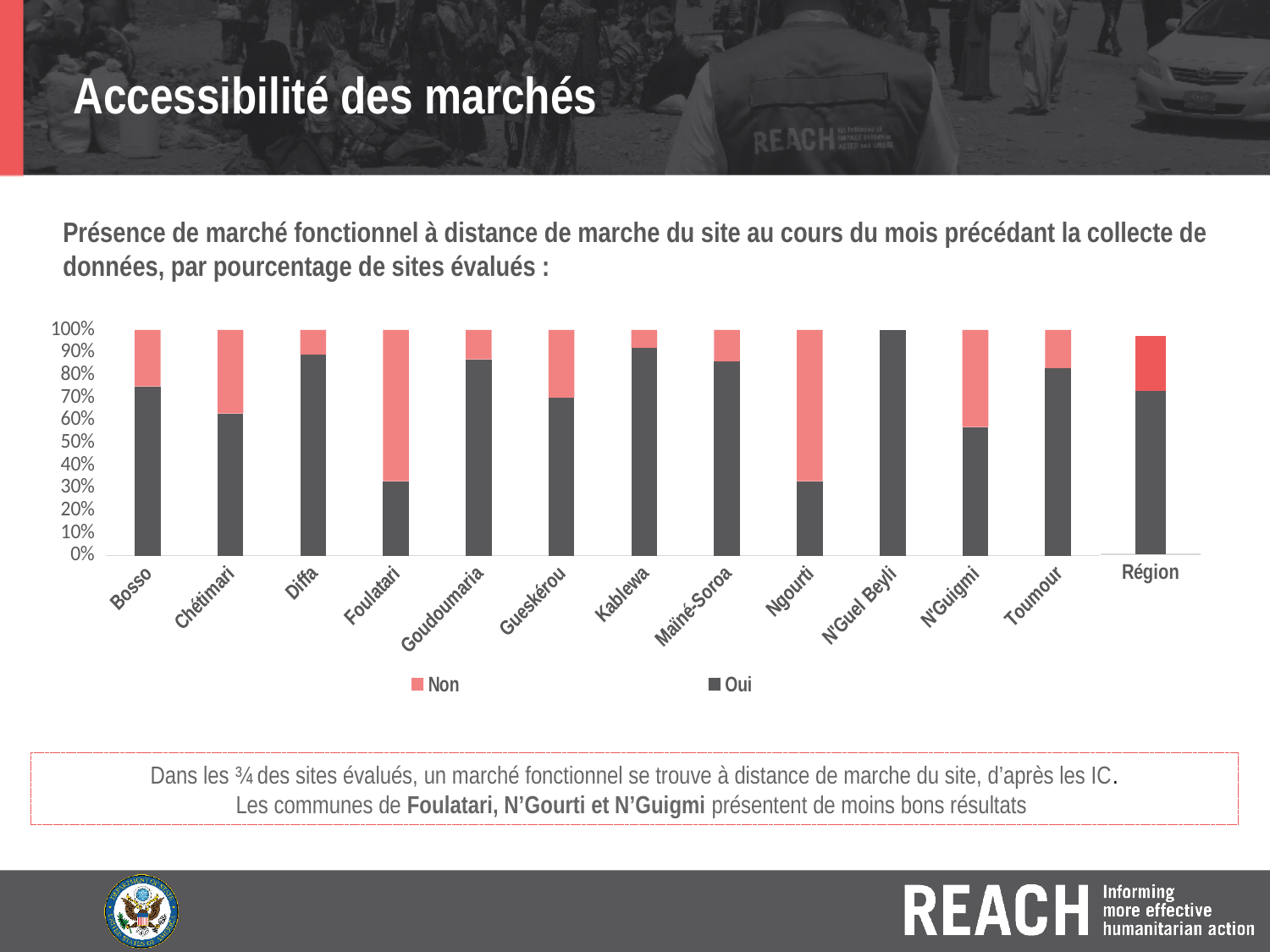
How many series does the chart legend list? 2 Is the 'Oui' value for Région greater or less than 60%? greater Is the 'Oui' value for Kablewa greater or less than 80%? greater Which category has the highest share of 'Oui'? N'Guel Beyli What are the two series named in the chart legend? Non and Oui Is the 'Oui' value for Chétimari greater or less than 70%? less Which has a larger 'Non' share, Ngourti or Toumour? Ngourti What is the 'Oui' value for N'Guel Beyli? 100% Which has a larger 'Oui' share, Diffa or Chétimari? Diffa What kind of chart is shown on the slide? stacked bar chart